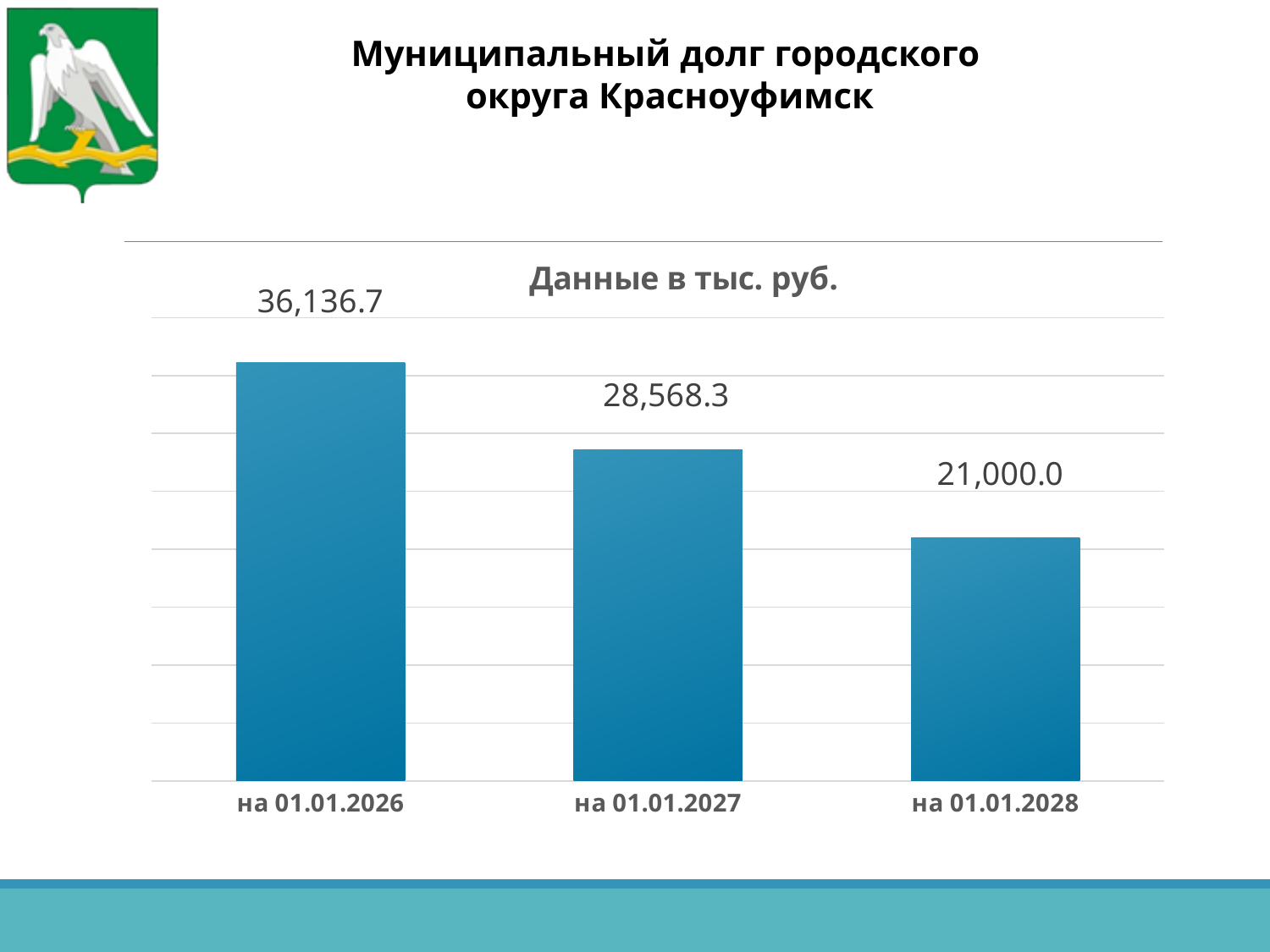
What is the municipal debt value shown for на 01.01.2028? 21,000.0 How many bars are shown in the chart? 3 What is the municipal debt value shown for на 01.01.2027? 28,568.3 Which date has the lowest municipal debt value? на 01.01.2028 What type of chart is shown on the slide? Bar chart What is the difference between the values for на 01.01.2027 and на 01.01.2028? 7,568.3 What is the difference between the values for на 01.01.2026 and на 01.01.2027? 7,568.4 What is the municipal debt value shown for на 01.01.2026? 36,136.7 Do the values rise or fall from на 01.01.2026 to на 01.01.2028? Fall Which is larger, the value for на 01.01.2027 or the value for на 01.01.2028? на 01.01.2027 Which date has the highest municipal debt value? на 01.01.2026 What is the difference between the values for на 01.01.2026 and на 01.01.2028? 15,136.7